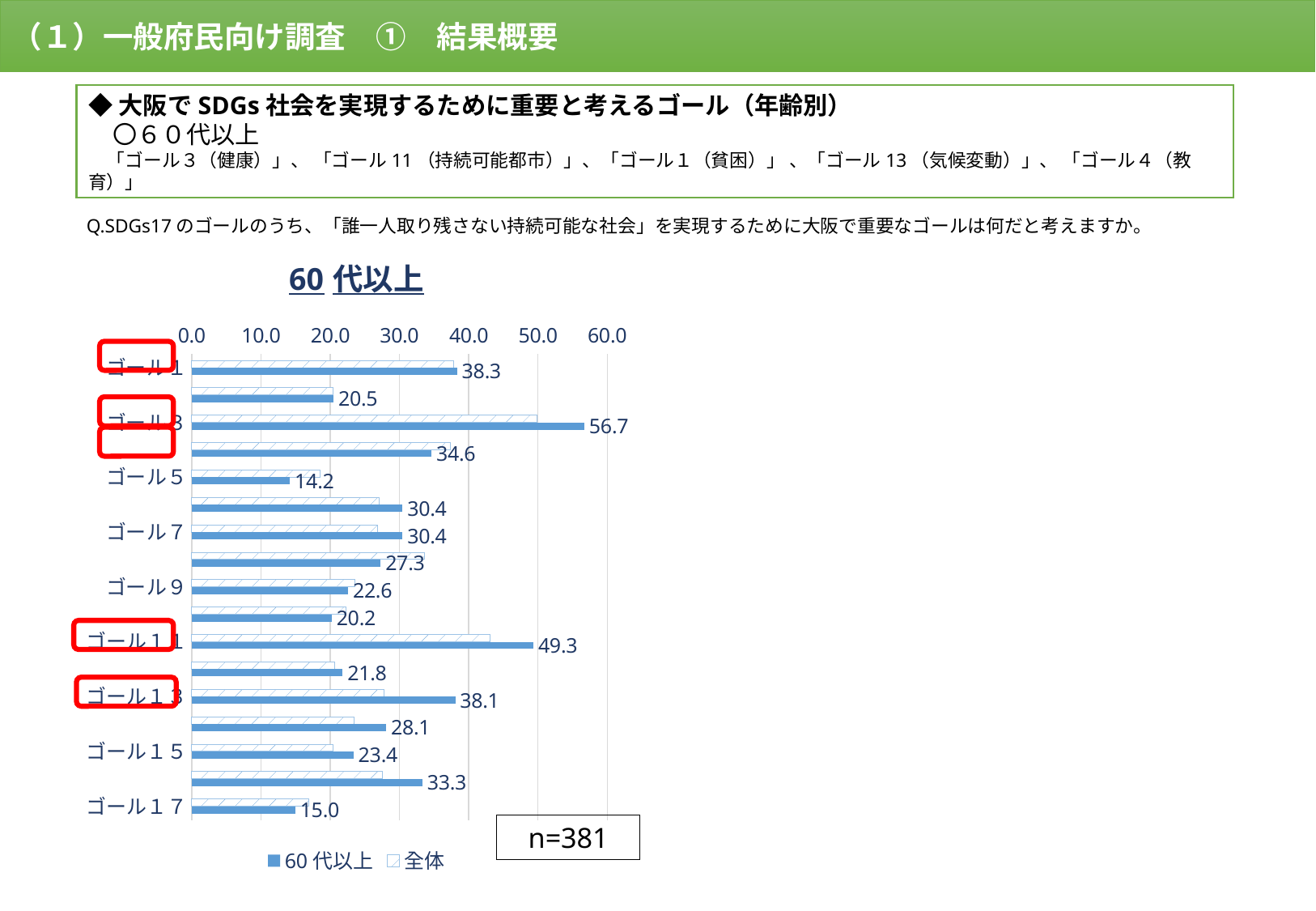
What is the value for ゴール１７ in the 60 代以上 series? 15.0 What is the difference between the 60 代以上 values for ゴール１１ and ゴール１３? 11.2 Which goal has the lowest value in the 60 代以上 series? ゴール５ What kind of chart is shown on the slide? bar chart What is the value for ゴール１５ in the 60 代以上 series? 23.4 Which goal has the highest value in the 60 代以上 series? ゴール３ What sample size (n) is shown next to the chart? n=381 What is the value for ゴール５ in the 60 代以上 series? 14.2 Which has the larger 60 代以上 value, ゴール７ or ゴール９? ゴール７ What is the value for ゴール１１ in the 60 代以上 series? 49.3 Is the 全体 value for ゴール３ greater or less than 40.0? greater How many series does the legend list? 2